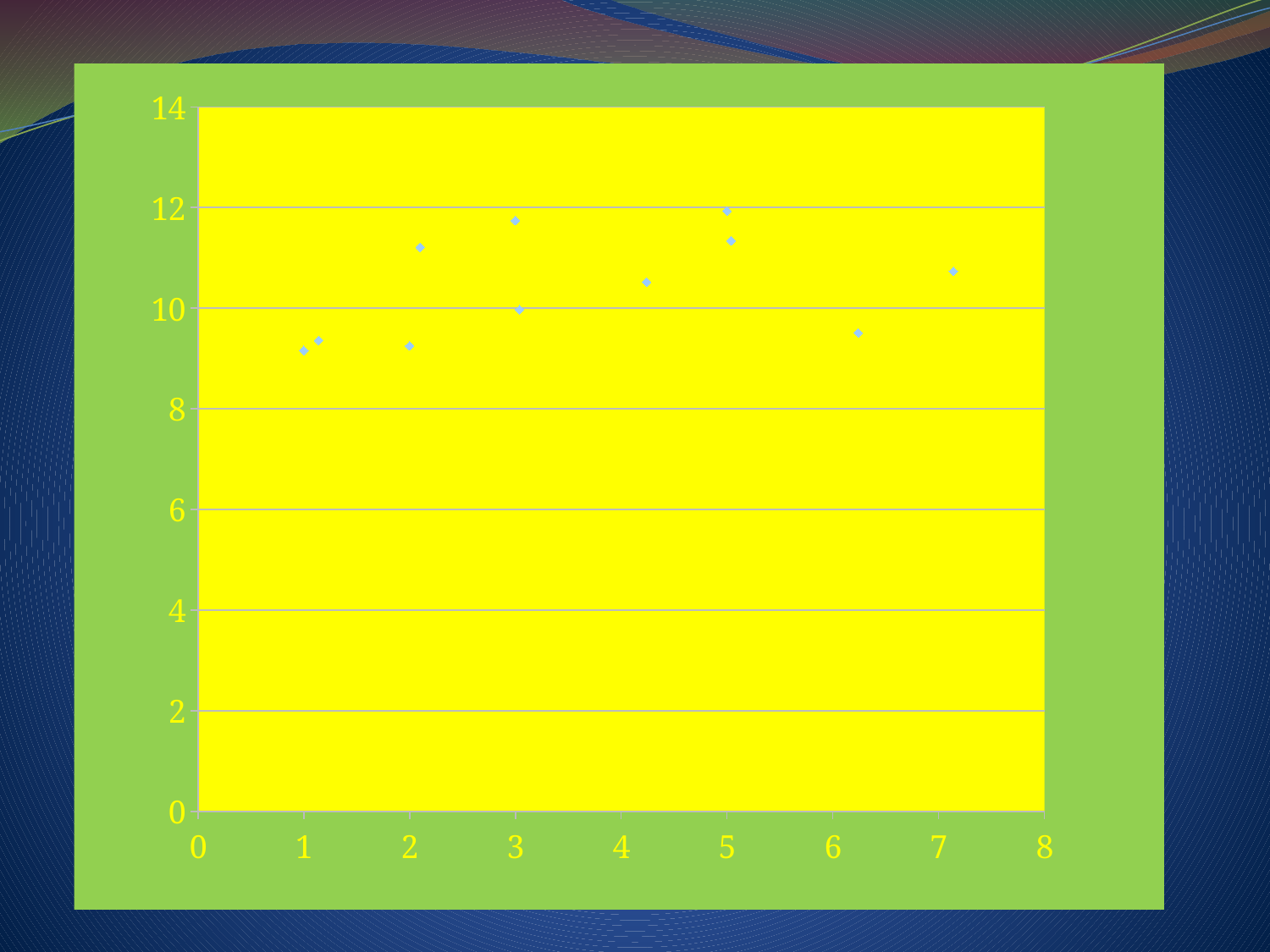
Is the value of the point at x = 1 greater or less than 10? less What is the highest value shown on the horizontal axis? 8 What kind of chart is shown on the slide? scatter plot How many data points are plotted on the chart? 11 Is the value of the point at x = 7 greater or less than 10? greater What is the highest value shown on the vertical axis? 14 Is the value of the point at x = 6 greater or less than 10? less